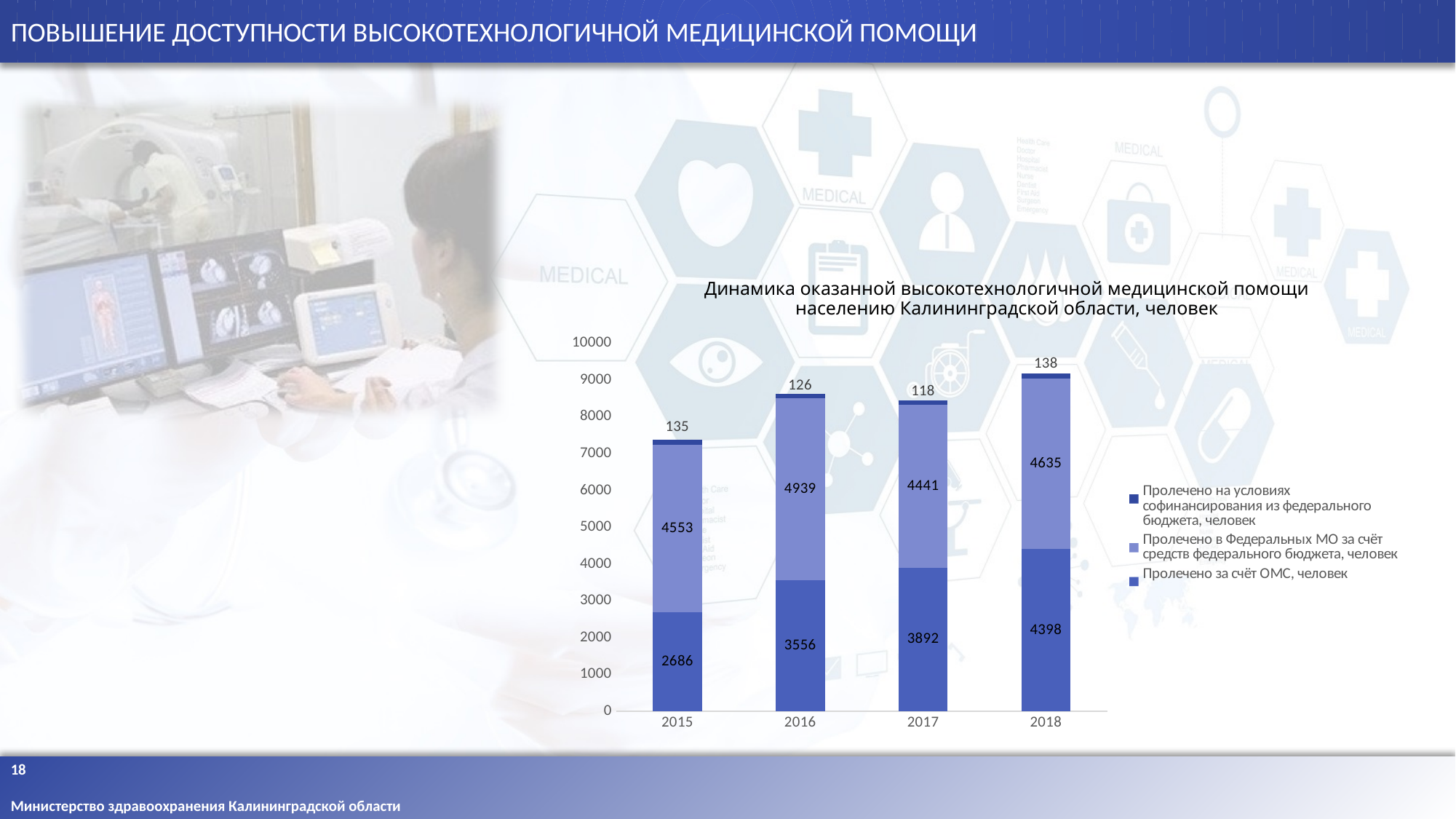
What is the value of the middle (light blue) segment of the 2016 bar? 4939 Which is larger, the middle segment value for 2016 or for 2017? 2016 What is the difference between the bottom segment values for 2018 and 2015? 1712 What is the small value printed above the 2018 bar? 138 What type of chart is shown on the slide? Stacked bar chart What is the value of the bottom (dark blue) segment of the 2015 bar? 2686 In which year is the bottom (dark blue) segment the largest? 2018 How many series does the chart legend list? 3 How many years are shown on the x axis of the chart? 4 In which year is the bottom (dark blue) segment the smallest? 2015 What is the total of the stacked bar for 2018? 9171 Do the bottom (dark blue) segment values rise or fall from 2015 to 2018? Rise